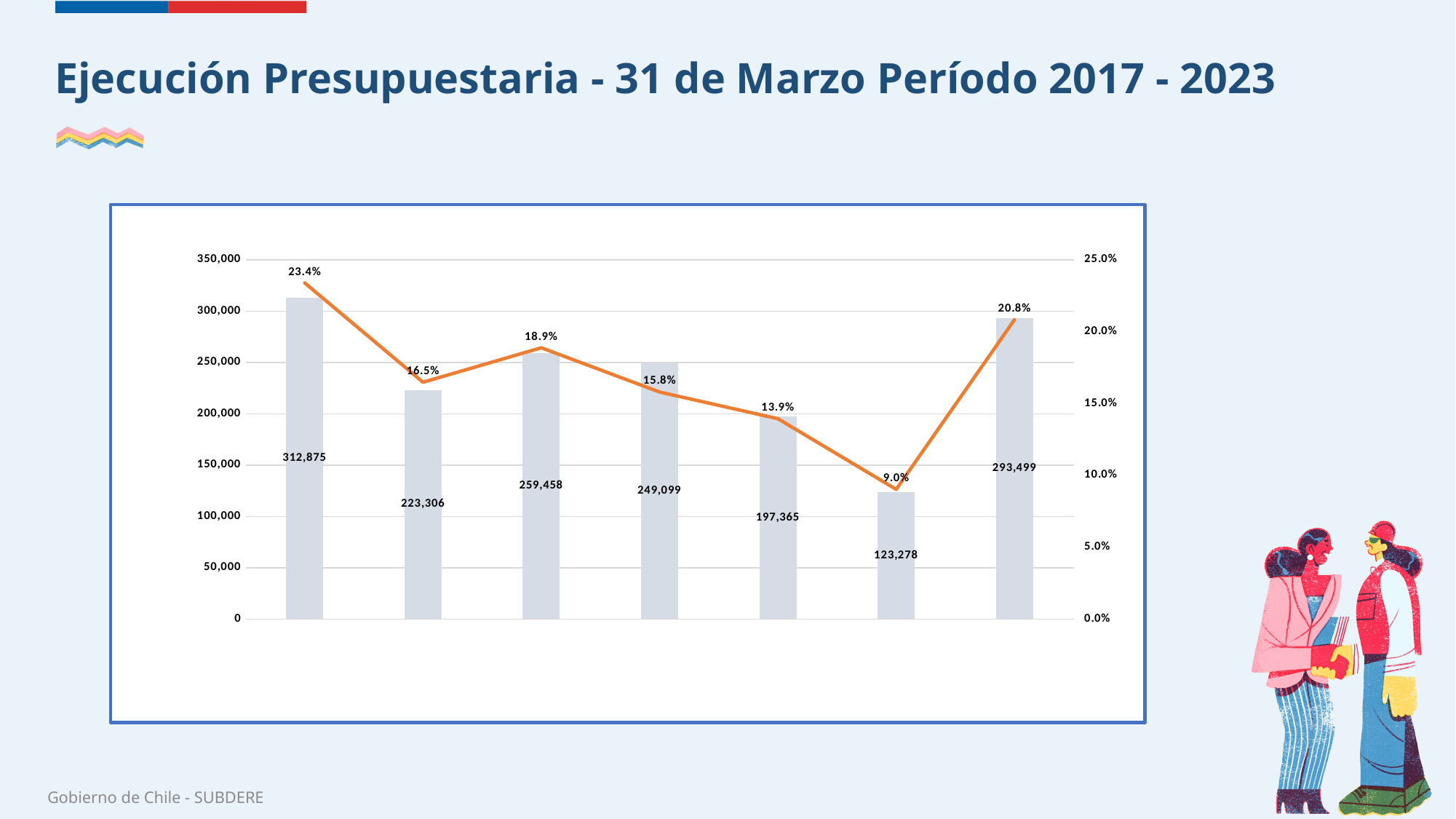
What is the value of the third bar from the left? 259,458 What is the value of the leftmost (first) bar? 312,875 Which bar has the lowest value, and what is it? The sixth bar, 123,278 What kind of chart is shown on the slide? A bar chart with a line Is the value of the fifth bar greater or less than 200,000? less What is the lowest percentage shown on the line? 9.0% What is the difference between the first bar (312,875) and the last bar (293,499)? 19,376 How many bars are plotted in the chart? 7 What percentage is labelled on the last (rightmost) point of the line? 20.8% What is the highest bar value in the chart? 312,875 Which is larger, the second bar or the fourth bar? The fourth bar (249,099) Does the line rise or fall from the first point to the sixth point? It falls